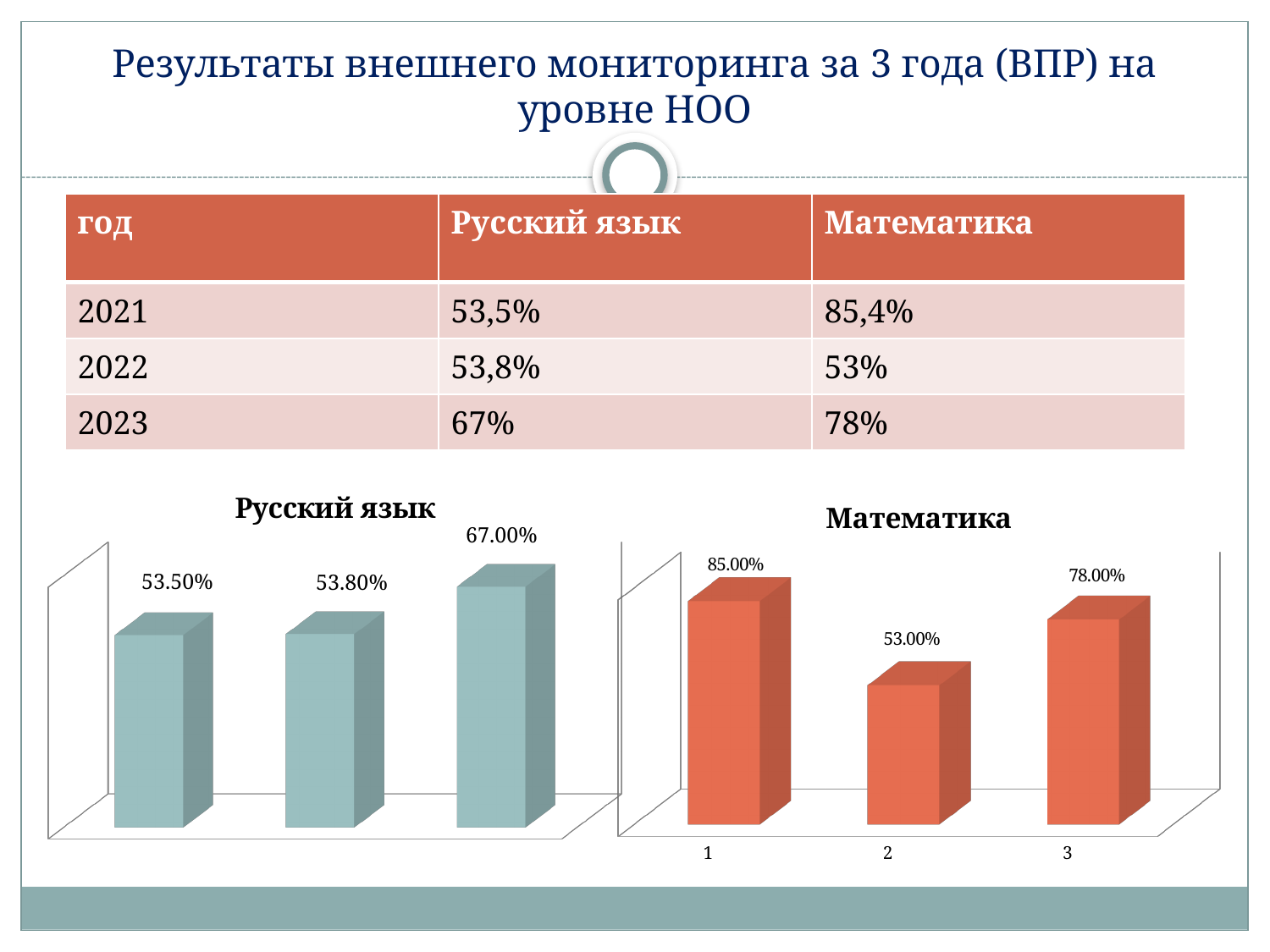
In the "Математика" chart, what is the value for category 2? 53.00% In the "Русский язык" chart, do the values rise or fall from left to right? rise In the "Математика" chart, what is the difference between the values for category 1 and category 2? 32.00% How many bars are plotted in the "Русский язык" chart? 3 In the "Математика" chart, which is larger: the value for category 1 or category 3? category 1 In the "Русский язык" chart, what is the value shown on the third (rightmost) bar? 67.00% In the "Математика" chart, which category has the highest value? 1 What type of chart is the "Математика" chart? bar chart In the "Русский язык" chart, what is the value shown on the first (leftmost) bar? 53.50% In the "Математика" chart, what is the value for category 3? 78.00% In the "Математика" chart, which category has the lowest value? 2 In the "Русский язык" chart, what is the difference between the third bar and the first bar? 13.50%